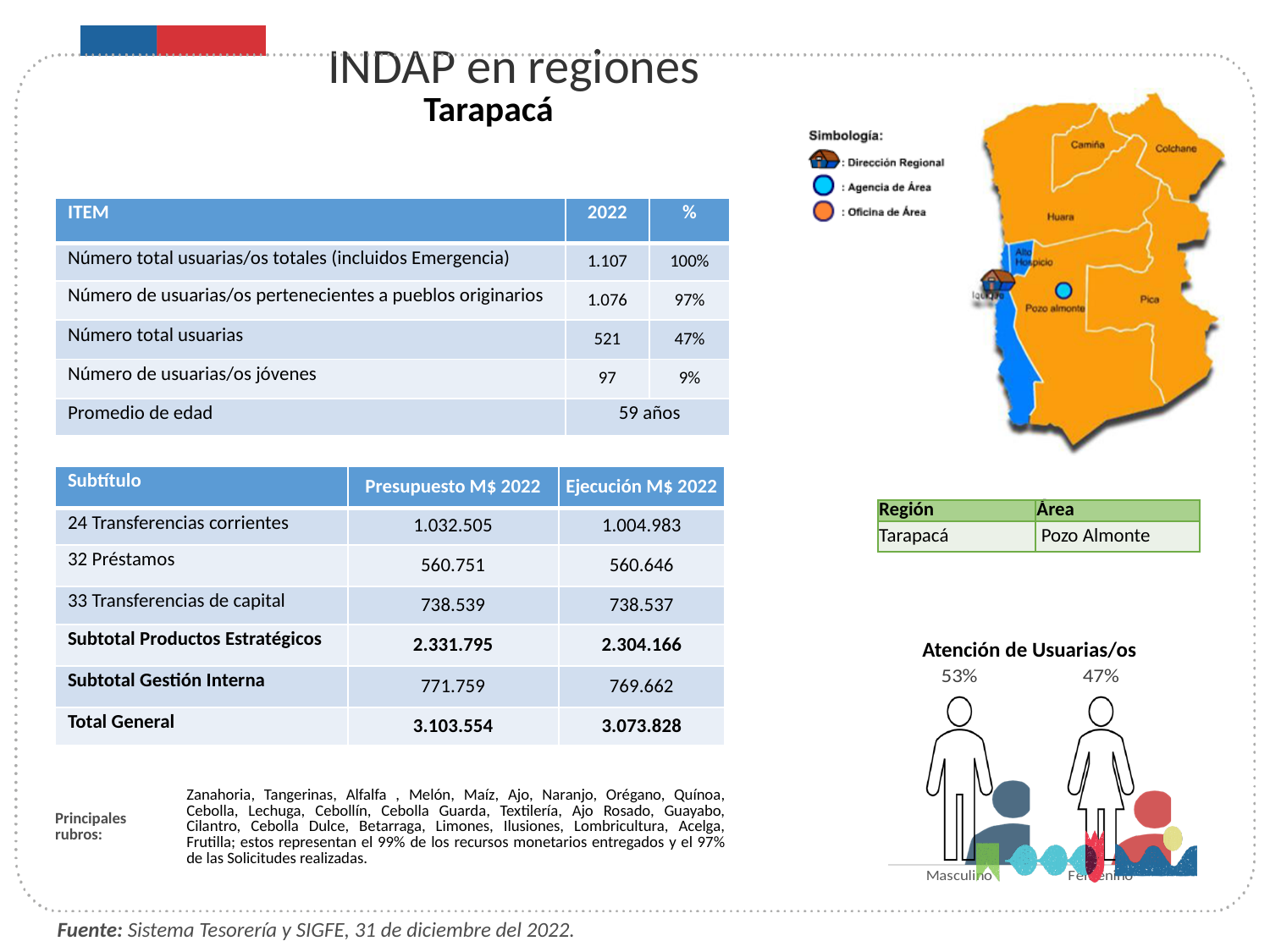
In the 'Atención de Usuarias/os' chart, what is the difference between the Masculino and Femenino percentages? 6% What is the title of the chart in the lower right of the slide? Atención de Usuarias/os How many categories are shown in the 'Atención de Usuarias/os' chart? 2 In the 'Atención de Usuarias/os' chart, which category is shown on the left? Masculino In the 'Atención de Usuarias/os' chart, which category has the higher percentage? Masculino In the 'Atención de Usuarias/os' chart, what percentage is shown for Femenino? 47% In the 'Atención de Usuarias/os' chart, what do the Masculino and Femenino percentages add up to? 100% In the 'Atención de Usuarias/os' chart, is the value for Masculino larger or smaller than the value for Femenino? larger In the 'Atención de Usuarias/os' chart, what percentage is shown for Masculino? 53% In the 'Atención de Usuarias/os' chart, which category has the lower percentage? Femenino